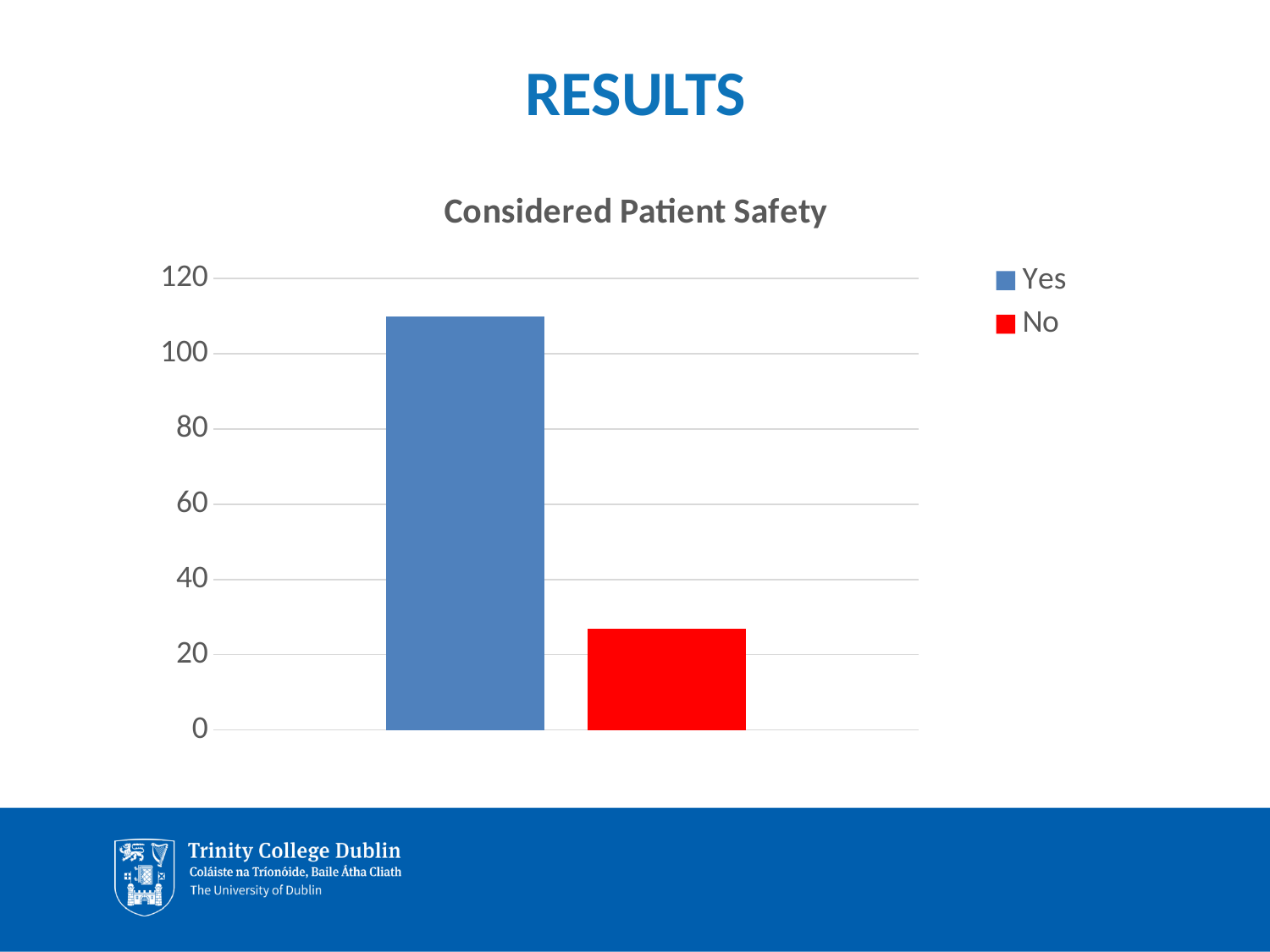
How many bars are plotted in the chart? 2 Which series has the lowest value, Yes or No? No How many series does the legend list? 2 Is the value for No greater or less than 20? greater What colour is the bar for the No series? red What kind of chart is shown on the slide? bar chart What is the title of the chart? Considered Patient Safety Is the value for Yes greater or less than 120? less Which series has the highest value, Yes or No? Yes Is the value for Yes greater or less than 100? greater Is the value for Yes larger or smaller than the value for No? larger